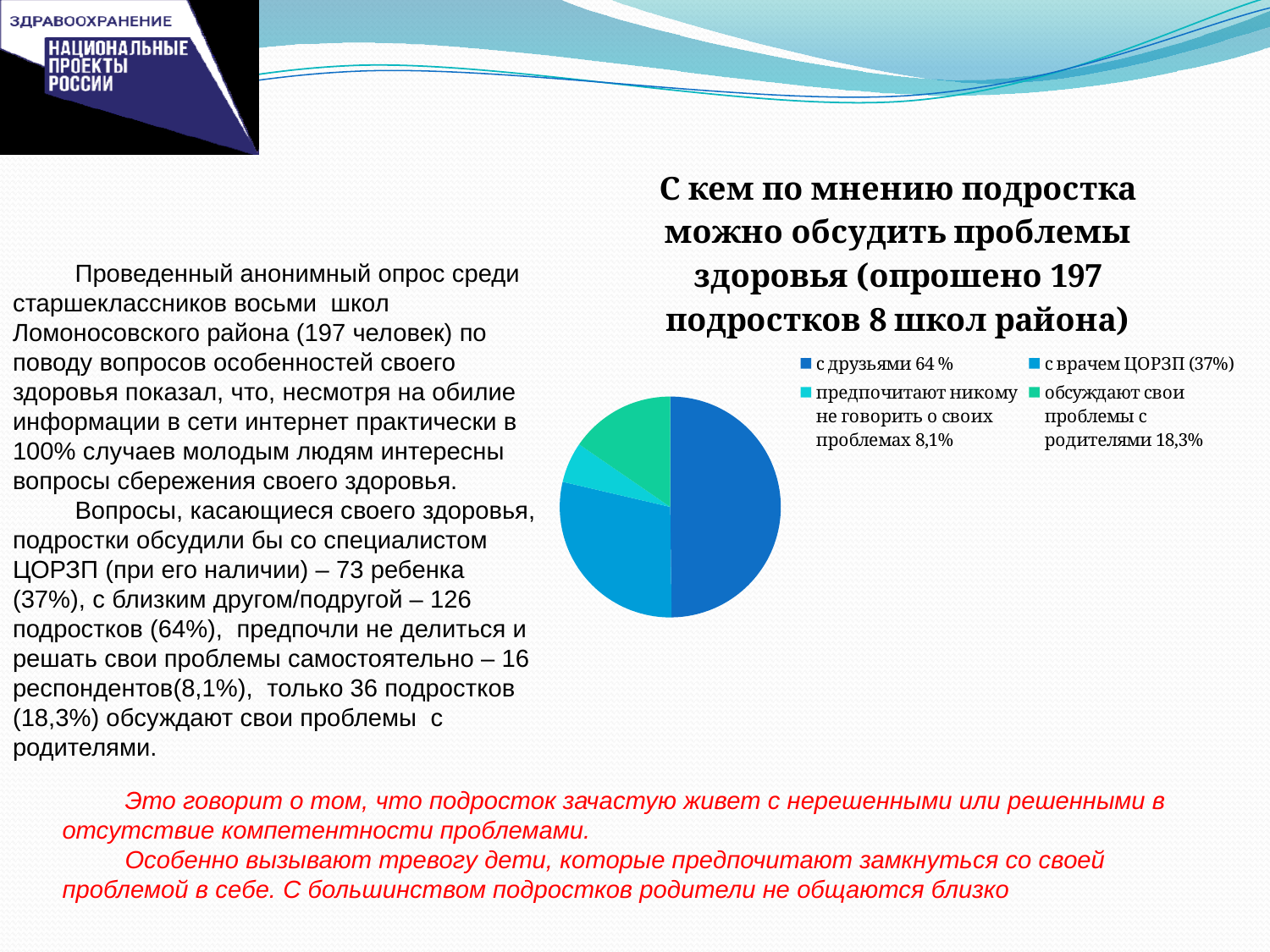
What percentage is given in the legend for 'с друзьями'? 64 % What percentage is given in the legend for 'предпочитают никому не говорить о своих проблемах'? 8,1% What kind of chart is shown on the slide? Pie chart What percentage is given in the legend for 'с врачем ЦОРЗП'? 37% What colour is the largest slice of the pie chart? Blue What is the title of the pie chart? С кем по мнению подростка можно обсудить проблемы здоровья (опрошено 197 подростков 8 школ района) Which category has the smallest slice of the pie chart? предпочитают никому не говорить о своих проблемах Which is larger: the value for 'с врачем ЦОРЗП' or for 'обсуждают свои проблемы с родителями'? с врачем ЦОРЗП How many categories does the pie chart have? 4 How many entries does the legend of the pie chart list? 4 Which category has the largest slice of the pie chart? с друзьями What percentage is given in the legend for 'обсуждают свои проблемы с родителями'? 18,3%